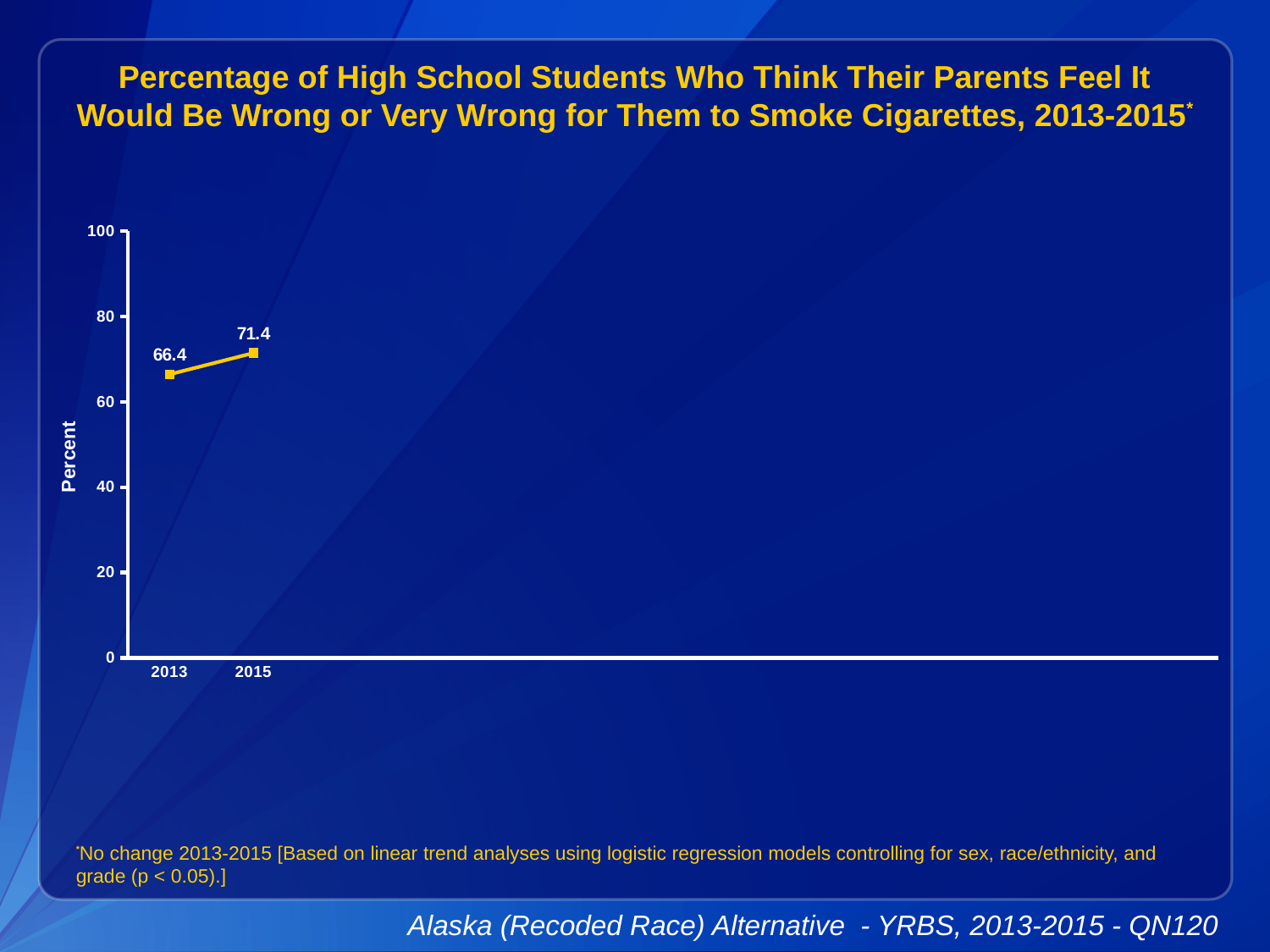
What kind of chart is shown? line chart What is the difference between the 2015 and 2013 values? 5.0 Is the value for 2013 greater or less than 60? greater How many years are plotted on the chart? 2 Which year has the lower value? 2013 What is the value for 2013? 66.4 Which year has the higher value? 2015 What is the maximum value shown on the y axis? 100 Do the values rise or fall from 2013 to 2015? rise Is the value for 2015 greater or less than 80? less What is the value for 2015? 71.4 What is the label on the y axis? Percent